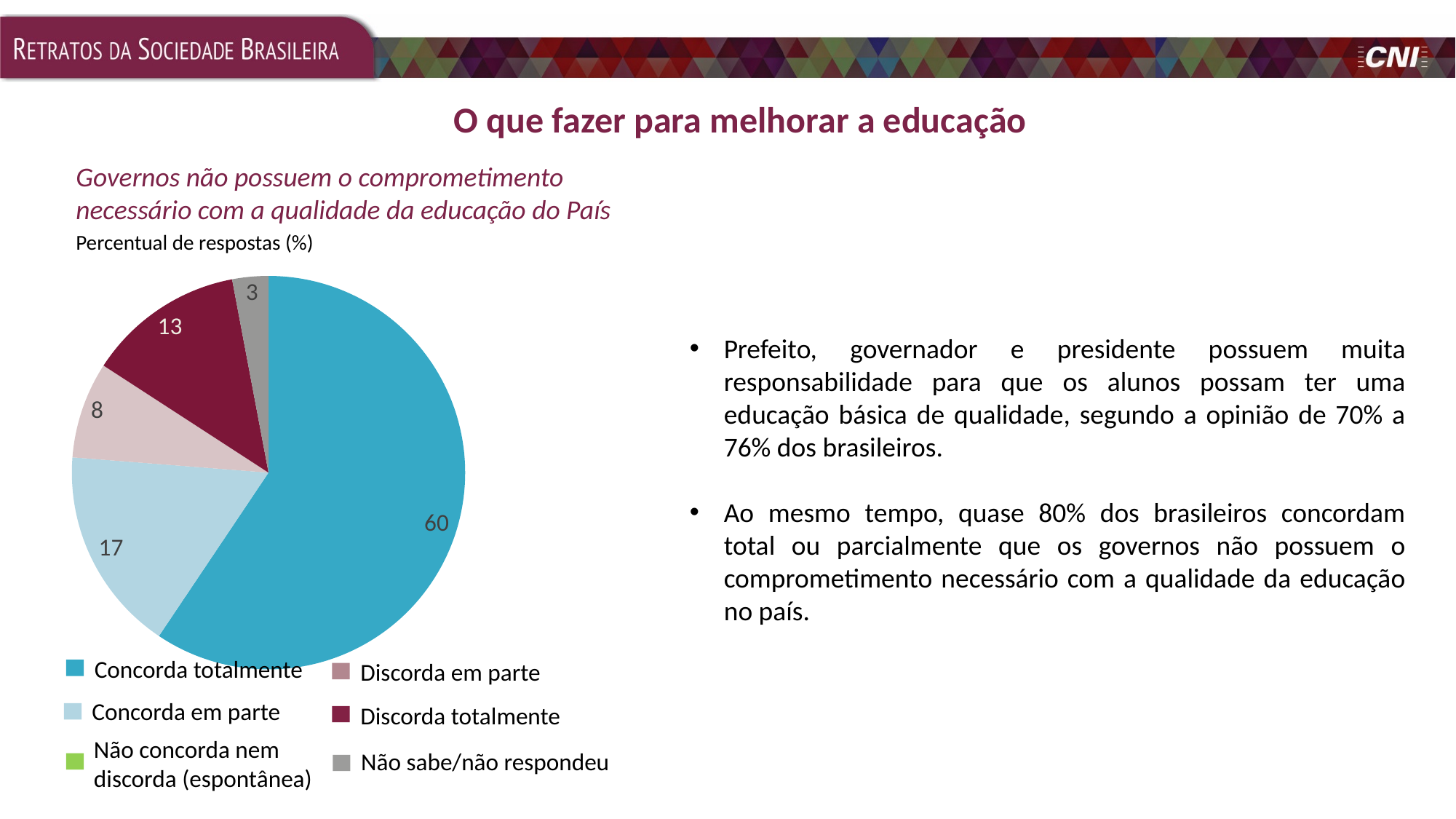
What percentage of respondents answered "Concorda totalmente"? 60 Which labelled slice of the pie is the smallest? Não sabe/não respondeu What value is shown for "Concorda em parte"? 17 What value is shown for "Discorda totalmente"? 13 What type of chart is shown on the slide? Pie chart Which is larger, "Discorda totalmente" or "Discorda em parte"? Discorda totalmente How many slices with data labels does the pie chart show? 5 What value is shown for "Não sabe/não respondeu"? 3 How many entries does the chart legend list? 6 What is the difference between the values for "Concorda totalmente" and "Concorda em parte"? 43 What is the combined value of "Concorda totalmente" and "Concorda em parte"? 77 Which response category has the largest slice of the pie? Concorda totalmente